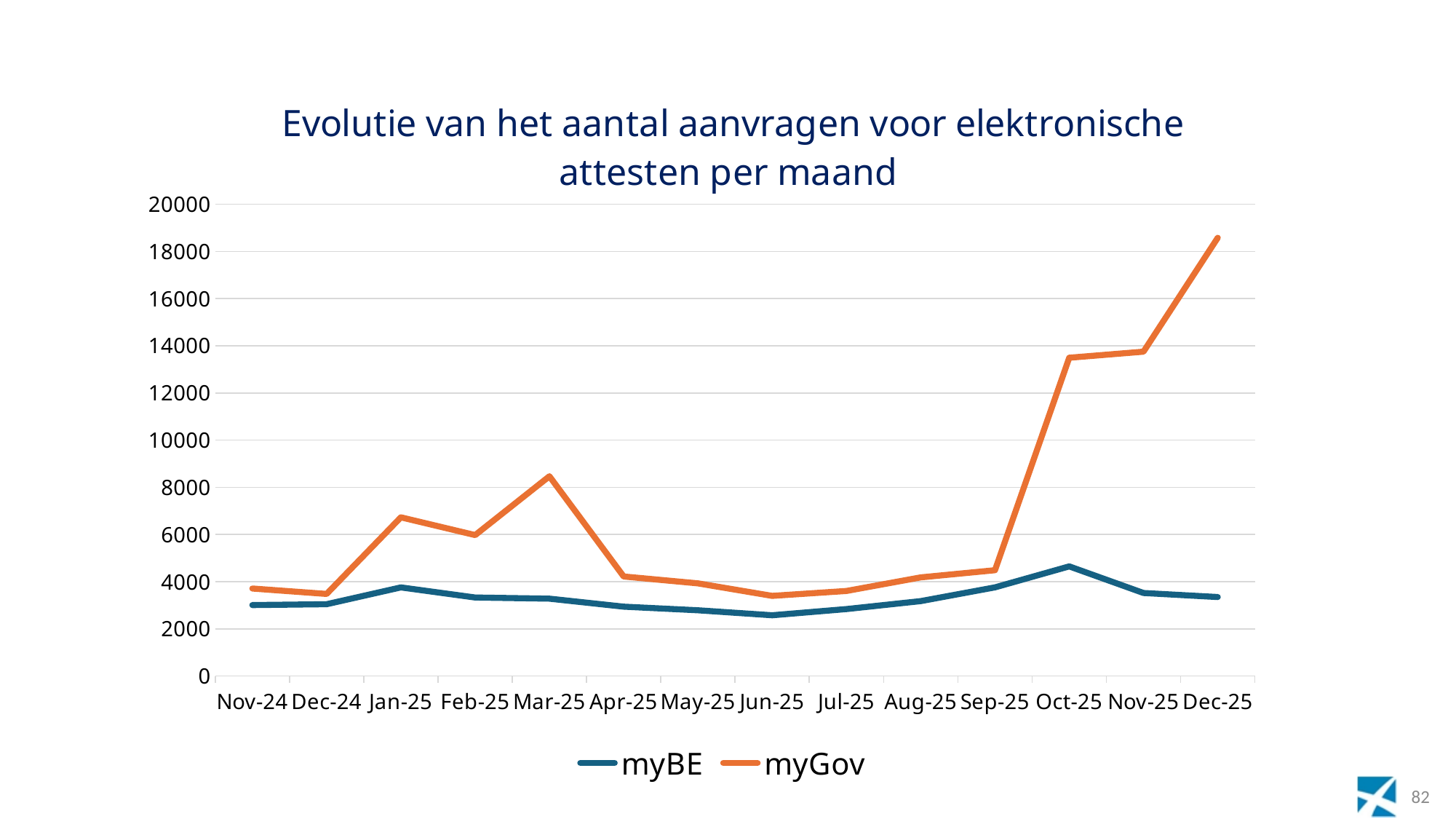
In which month does the myBE series reach its lowest value? Jun-25 Is the value for myGov in Oct-25 greater or less than 12000? greater Is the value for myBE in Jun-25 greater or less than 4000? less How many months are plotted along the x axis? 14 Is the value for myGov in Dec-25 greater or less than 16000? greater In which month does the myGov series reach its highest value? Dec-25 Does the myGov series rise or fall from Sep-25 to Dec-25? rise How many series does the legend list? 2 What kind of chart is shown on the slide? line chart What is the title of the chart? Evolutie van het aantal aanvragen voor elektronische attesten per maand Which series has the larger value in Mar-25, myBE or myGov? myGov In which month does the myBE series reach its highest value? Oct-25